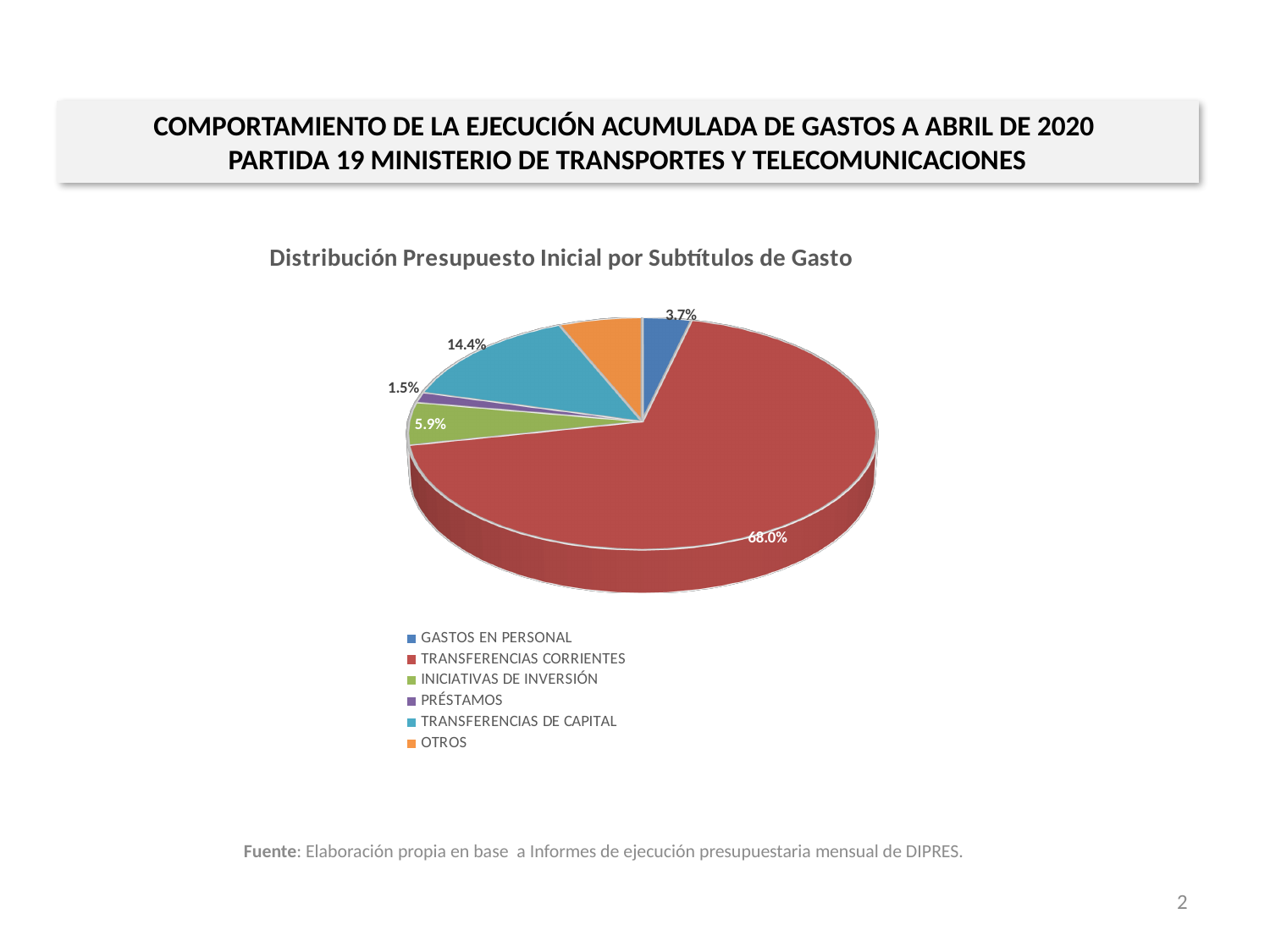
What is the value shown for TRANSFERENCIAS DE CAPITAL? 14.4% What is the title of the chart? Distribución Presupuesto Inicial por Subtítulos de Gasto What is the value shown for PRÉSTAMOS? 1.5% Which category has the largest slice of the pie? TRANSFERENCIAS CORRIENTES What share of the pie does TRANSFERENCIAS CORRIENTES represent? 68.0% What is the value shown for GASTOS EN PERSONAL? 3.7% Which category has the smallest slice of the pie? PRÉSTAMOS What kind of chart is shown on the slide? Pie chart What is the difference in percentage points between TRANSFERENCIAS DE CAPITAL and INICIATIVAS DE INVERSIÓN? 8.5 Which is larger, the slice for GASTOS EN PERSONAL or the slice for INICIATIVAS DE INVERSIÓN? INICIATIVAS DE INVERSIÓN How many categories does the legend of the pie chart list? 6 What is the value shown for INICIATIVAS DE INVERSIÓN? 5.9%